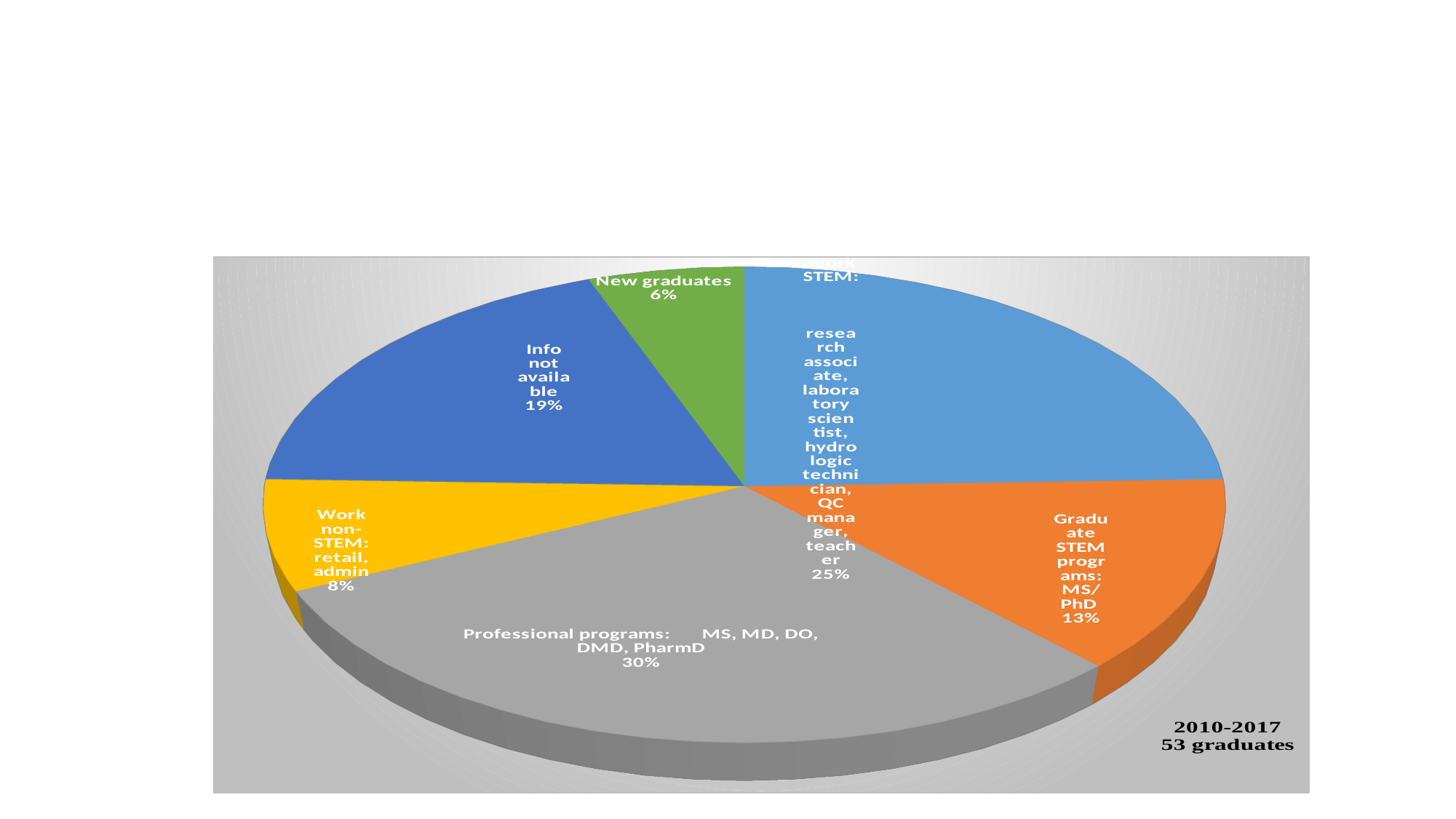
How many slices does the pie chart have? 6 Which slice of the pie chart is the largest? Professional programs: MS, MD, DO, DMD, PharmD Which slice of the pie chart is the smallest? New graduates According to the text on the chart, how many graduates does the chart cover for 2010-2017? 53 graduates What percentage is shown for "Info not available"? 19% What percentage is shown for "New graduates"? 6% Which is larger, the "Info not available" slice or the "Work non-STEM: retail, admin" slice? Info not available What share of the pie is labelled "Professional programs: MS, MD, DO, DMD, PharmD"? 30% What percentage is shown for "Graduate STEM programs: MS/PhD"? 13% What kind of chart is shown on the slide? Pie chart What is the difference in percentage points between the "Work STEM" slice and the "Graduate STEM programs: MS/PhD" slice? 12 What percentage is shown for "Work non-STEM: retail, admin"? 8%